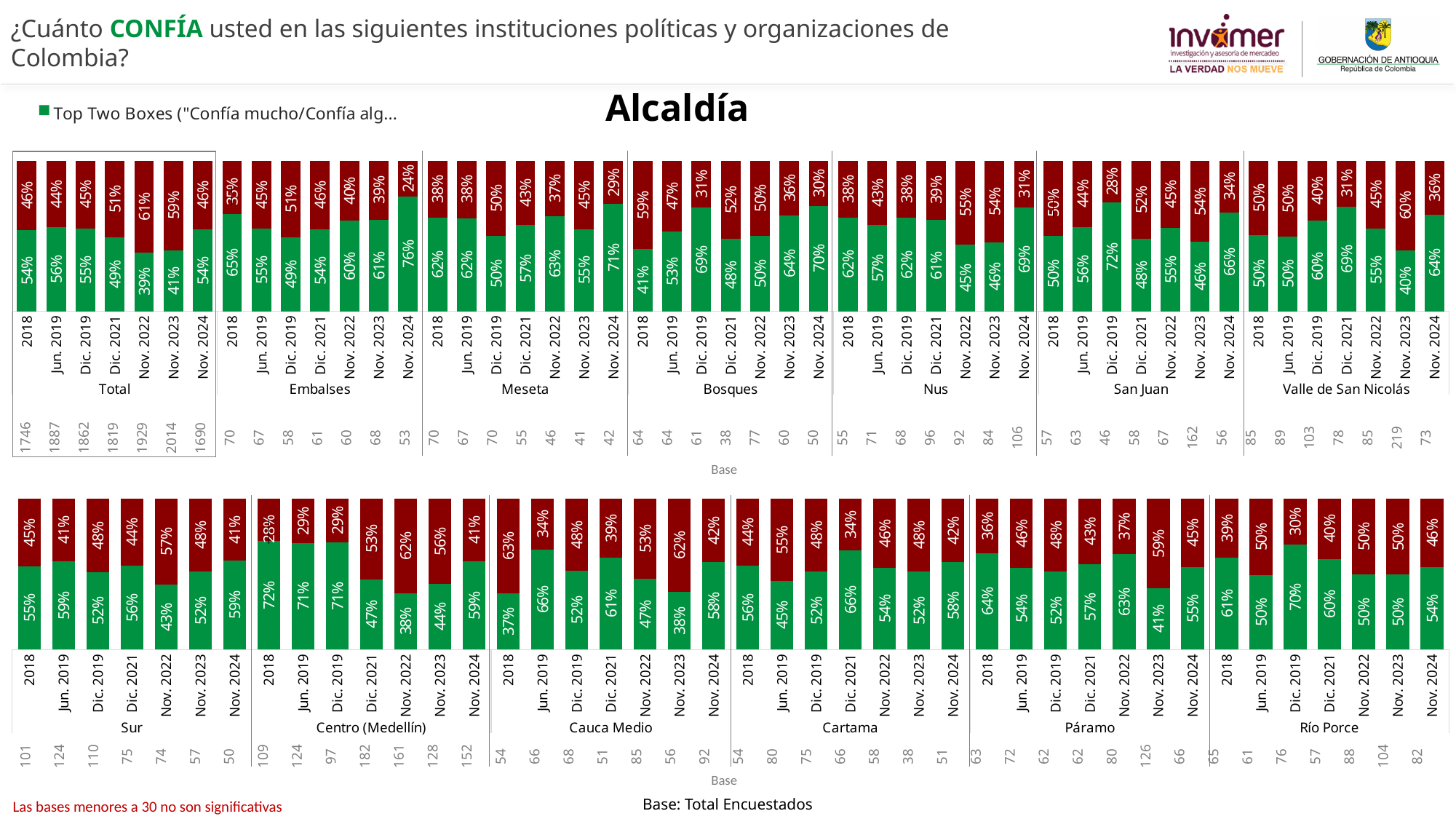
What is the title shown above the charts? Alcaldía In the top chart, what is the green (Top Two Boxes) value for Total in Nov. 2022? 39% What type of chart is shown on the slide? Stacked bar chart In the top chart, what is the green value for Embalses in Nov. 2024? 76% In the bottom chart, which is larger: the green value for Río Porce in Dic. 2019 or for Páramo in Dic. 2019? Río Porce in Dic. 2019 In the bottom chart, which year has the lowest green value within the Cauca Medio group? 2018 In the top chart, what is the total of the green and red segments for Nus in Nov. 2022? 100% In the top chart, how many bars are shown in the Total group? 7 In the top chart, which year has the highest green value within the Bosques group? Nov. 2024 In the top chart, what is the difference between the green values for Total in Jun. 2019 and Nov. 2022? 17% In the bottom chart, does the green value for Centro (Medellín) rise or fall from 2018 to Nov. 2022? Fall In the bottom chart, what is the red segment value for Centro (Medellín) in Nov. 2022? 62%